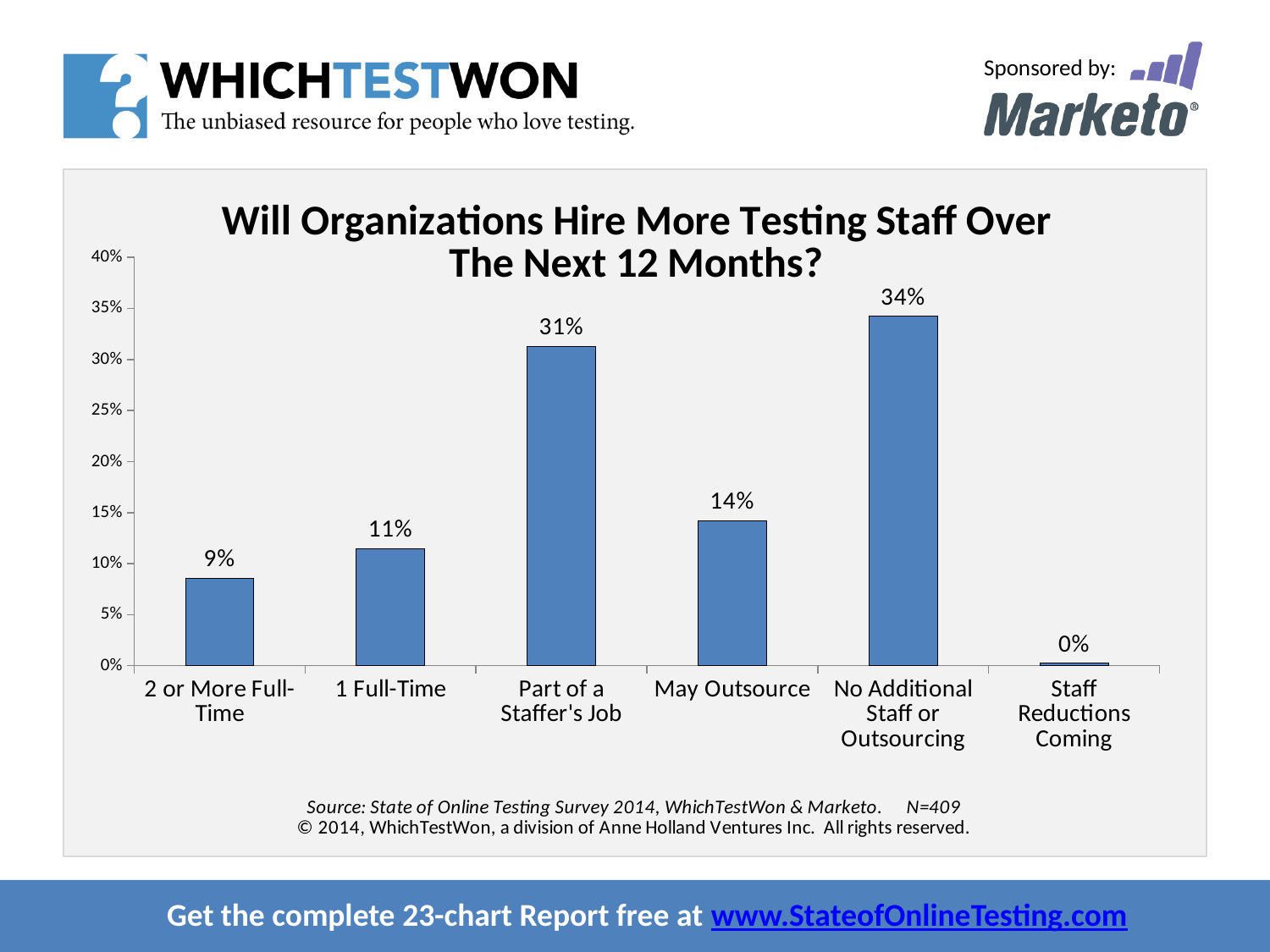
What is the title of the chart? Will Organizations Hire More Testing Staff Over The Next 12 Months? What is the value for 'Staff Reductions Coming'? 0% How many categories are shown on the x axis? 6 What percentage of organizations plan to hire 2 or more full-time testing staff? 9% What is the difference between 'No Additional Staff or Outsourcing' and 'Part of a Staffer's Job'? 3% What kind of chart is shown on the slide? Bar chart Which category has the lowest value? Staff Reductions Coming What percentage of organizations say they may outsource? 14% What is the value for 'Part of a Staffer's Job'? 31% Is the value for 'Part of a Staffer's Job' greater or less than 30%? greater Which is larger: '1 Full-Time' or 'May Outsource'? May Outsource Which category has the highest value? No Additional Staff or Outsourcing